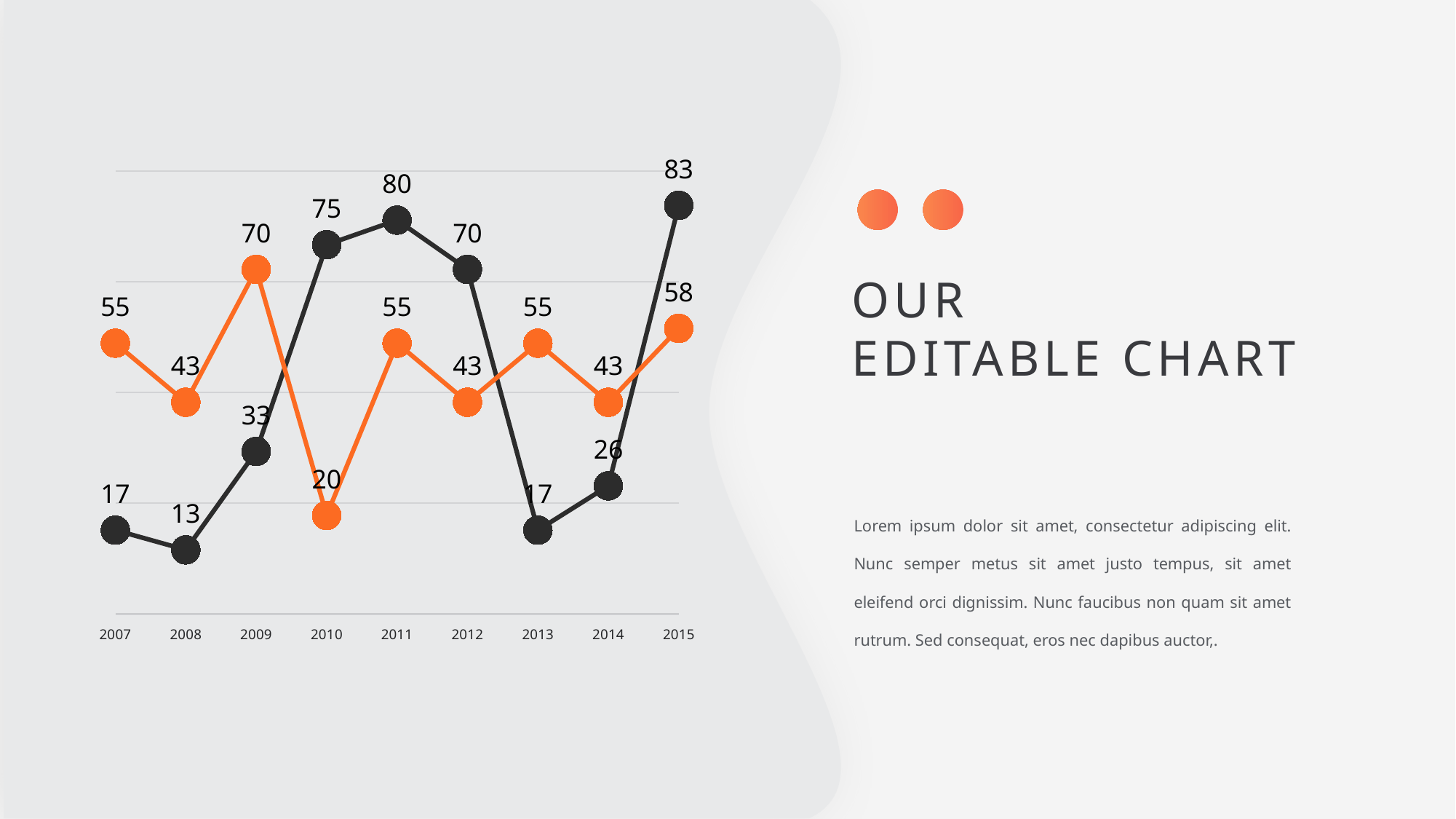
Which line has the higher value in 2013, the orange line or the dark line? orange line How many lines are plotted on the chart? 2 What is the value of the orange line in 2009? 70 What is the value of the dark line in 2011? 80 What kind of chart is shown on the slide? line chart What is the value of the dark line in 2015? 83 In which year does the orange line have its lowest value? 2010 In which year does the dark line reach its highest value? 2015 How many years are plotted along the x axis of the chart? 9 What is the value of the orange line in 2010? 20 What is the difference between the dark line and the orange line in 2010? 55 In which year does the dark line have its lowest value? 2008